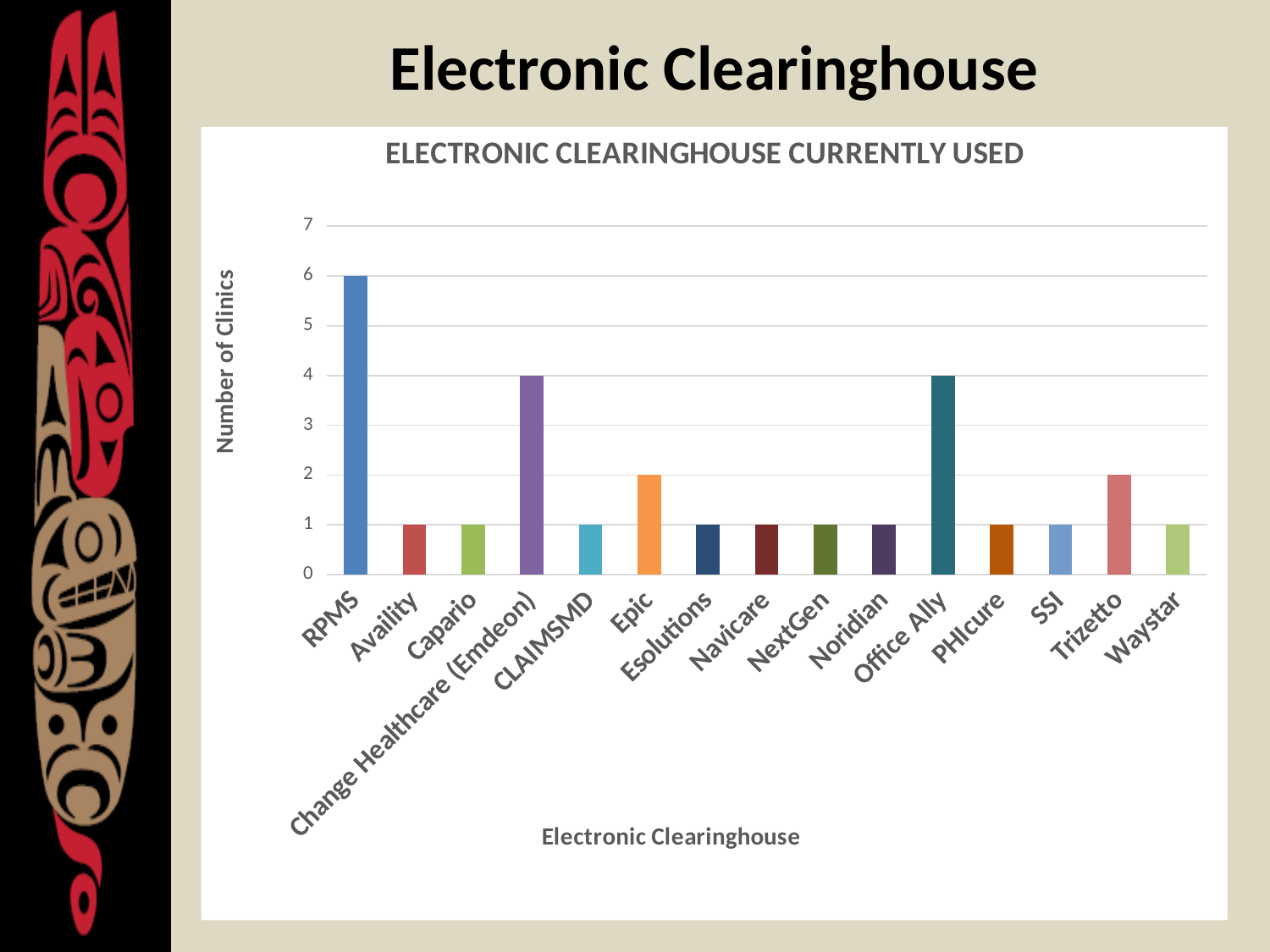
Is the value for RPMS greater or less than 5? greater What is the title of the chart? ELECTRONIC CLEARINGHOUSE CURRENTLY USED What is the number of clinics for Epic? 2 Which electronic clearinghouse is used by the most clinics? RPMS How many electronic clearinghouses are shown on the x axis? 15 What kind of chart is shown on the slide? Bar chart What is the label of the vertical axis? Number of Clinics What is the number of clinics for Office Ally? 4 Which has more clinics, Trizetto or Waystar? Trizetto What is the number of clinics for Change Healthcare (Emdeon)? 4 How many clinics use RPMS as their electronic clearinghouse? 6 What is the difference in number of clinics between RPMS and Office Ally? 2